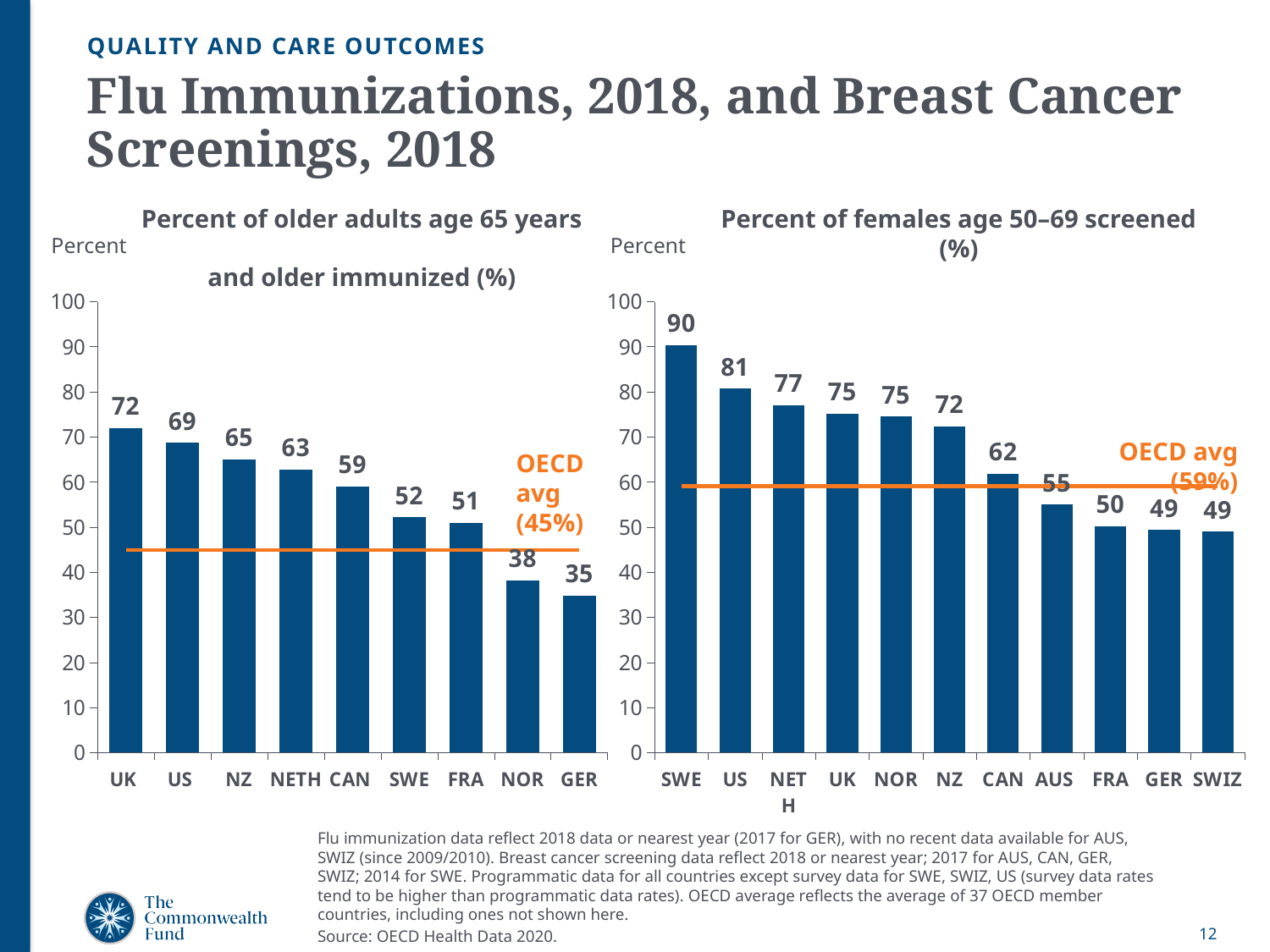
In the flu immunization chart (left), what is the difference between the values for the UK and GER? 37 In the flu immunization chart (left), which is larger, the value for NETH or the value for SWE? NETH How many countries are shown in the flu immunization chart (left)? 9 In the breast cancer screening chart (right), is the value for AUS greater or less than 60? less In the flu immunization chart (left), which country has the lowest value? GER In the flu immunization chart (left), what is the value for the UK? 72 How many countries are shown in the breast cancer screening chart (right)? 11 In the breast cancer screening chart (right), what is the value for CAN? 62 In the breast cancer screening chart (right), what is the difference between the values for SWE and the US? 9 What OECD average is marked on the flu immunization chart (left)? 45% In the breast cancer screening chart (right), which country has the highest value? SWE What kind of chart is the breast cancer screening chart (right)? Bar chart